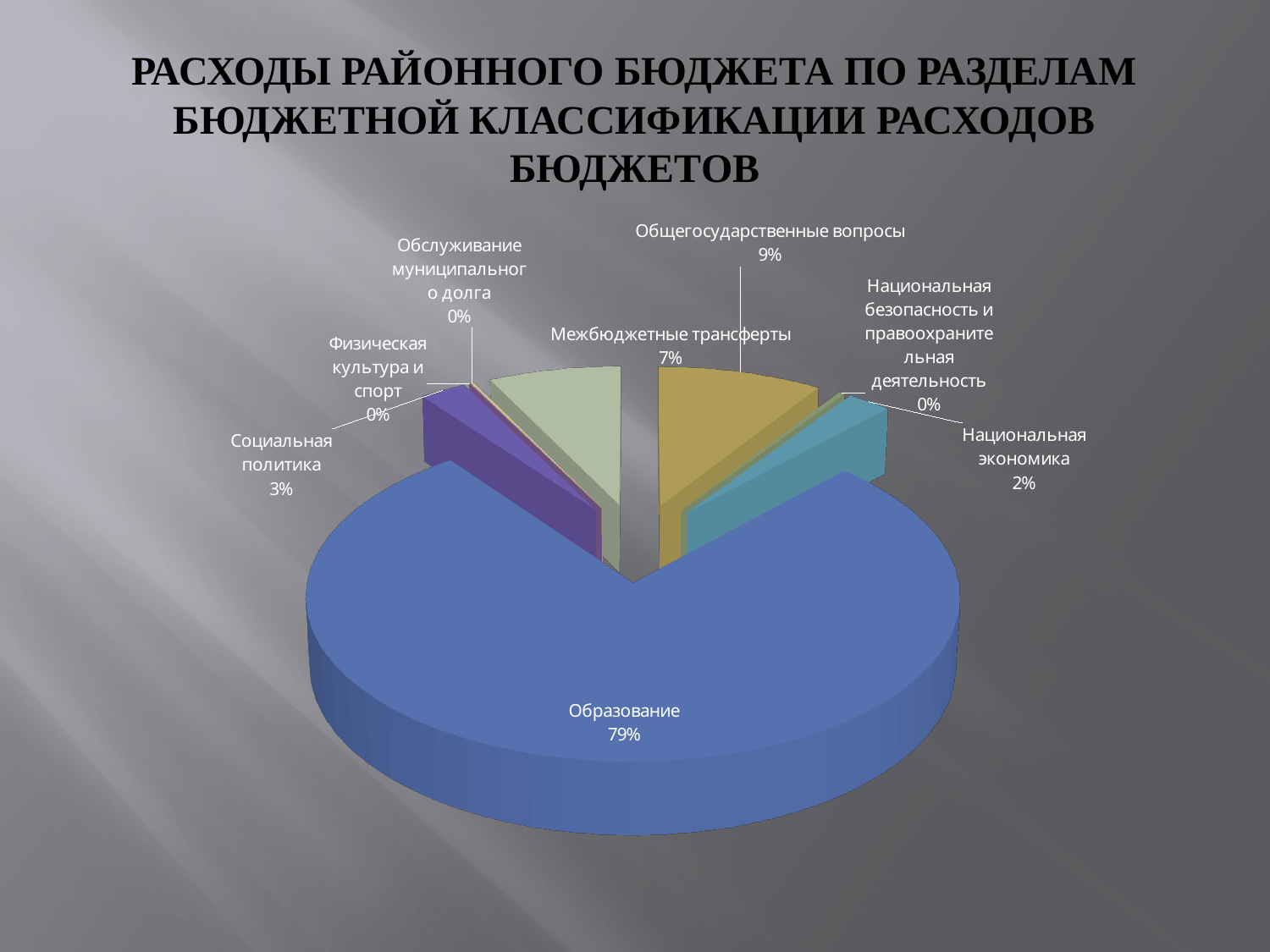
How many categories are shown in the pie chart? 8 What colour is the Образование slice? blue Which category has the largest share of the pie? Образование What is the value shown for Общегосударственные вопросы? 9% What is the value shown for Межбюджетные трансферты? 7% What is the difference in percentage points between Образование and Общегосударственные вопросы? 70 What share of the pie does Образование take? 79% Which is larger, Общегосударственные вопросы or Межбюджетные трансферты? Общегосударственные вопросы What is the value shown for Национальная экономика? 2% What is the value shown for Социальная политика? 3% What kind of chart is shown on the slide? pie chart What is the value shown for Физическая культура и спорт? 0%